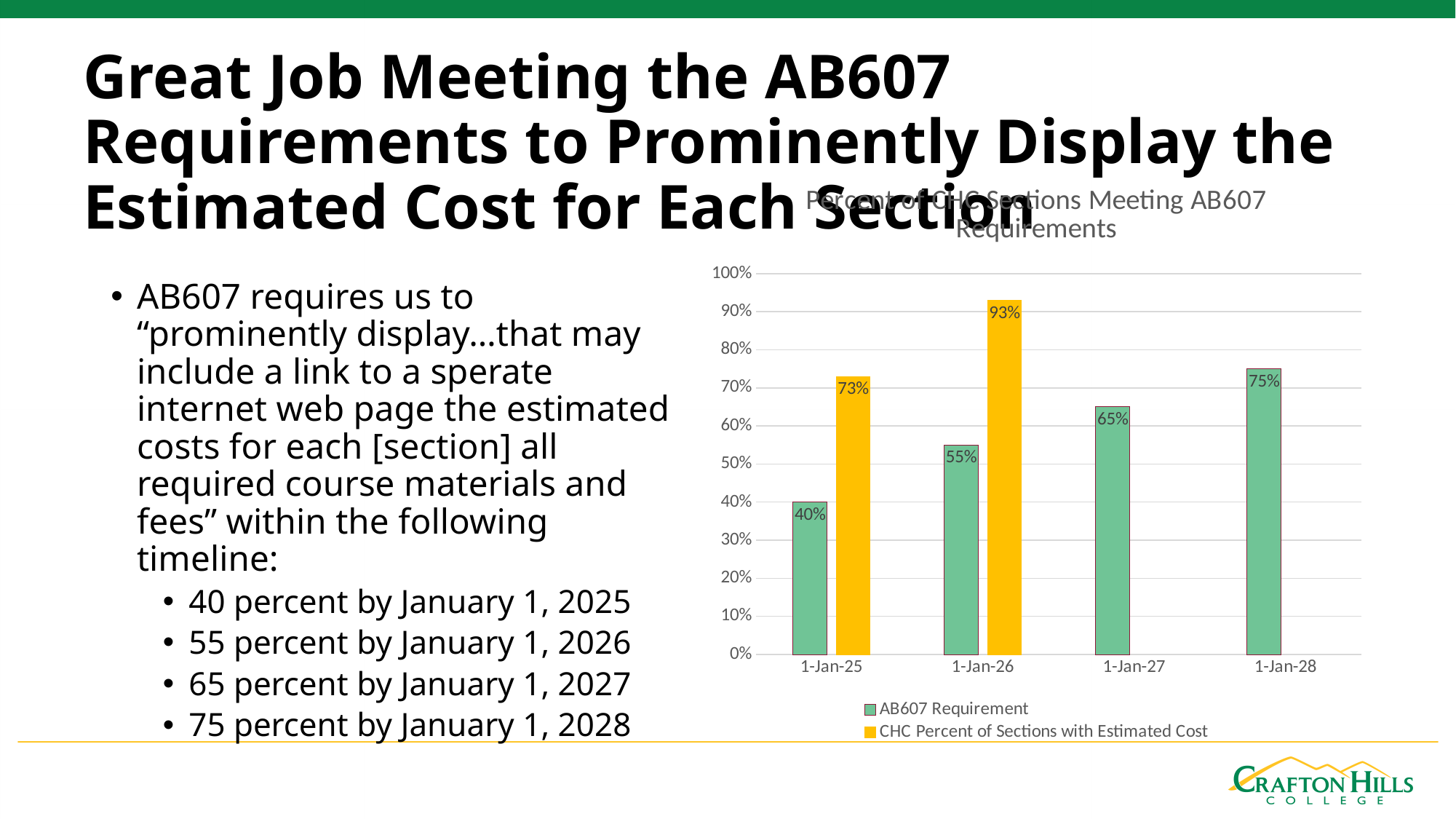
How many dates are shown on the x axis of the chart? 4 Which date has the lowest AB607 Requirement value? 1-Jan-25 Which date has the highest AB607 Requirement value? 1-Jan-28 What is the AB607 Requirement value for 1-Jan-25? 40% What kind of chart is shown on the slide? Bar chart What is the AB607 Requirement value for 1-Jan-28? 75% What is the title of the chart? Percent of CHC Sections Meeting AB607 Requirements What is the CHC Percent of Sections with Estimated Cost for 1-Jan-26? 93% How many series does the chart legend list? 2 For 1-Jan-26, which is larger: the AB607 Requirement or the CHC Percent of Sections with Estimated Cost? CHC Percent of Sections with Estimated Cost Do the AB607 Requirement values rise or fall from 1-Jan-25 to 1-Jan-28? Rise What is the difference between the CHC Percent of Sections with Estimated Cost and the AB607 Requirement for 1-Jan-25? 33%